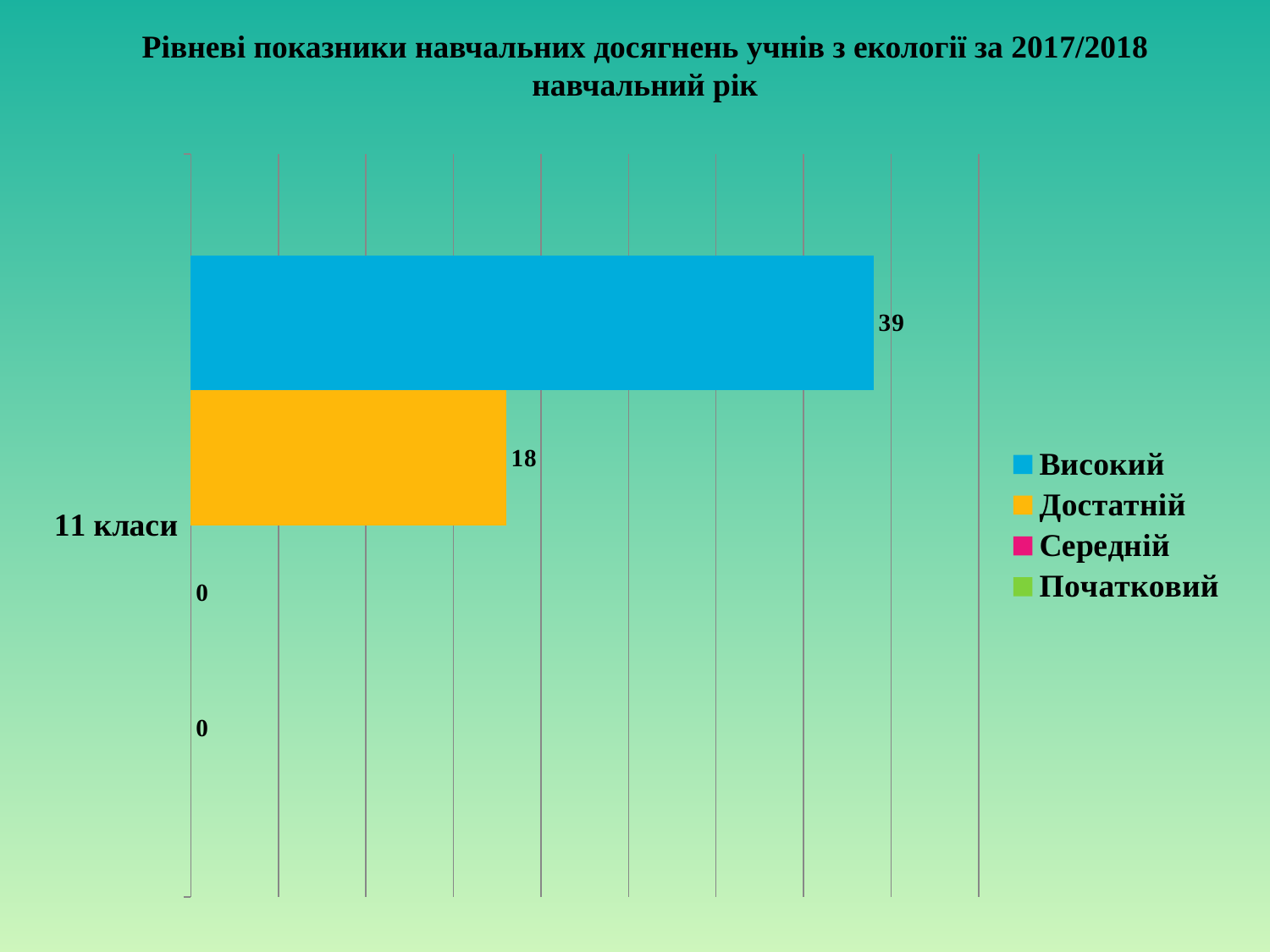
What is the value for Початковий for 11 класи? 0 How many categories are shown on the category axis? 1 What kind of chart is shown on the slide? bar chart What is the difference between the Високий and Достатній values for 11 класи? 21 What colour is the bar for Достатній? yellow Which is larger for 11 класи, Високий or Достатній? Високий What is the value for Достатній for 11 класи? 18 What is the value for Середній for 11 класи? 0 What is the value for Високий for 11 класи? 39 What is the total of all four series values for 11 класи? 57 Which series has the highest value for 11 класи? Високий How many series does the legend list? 4